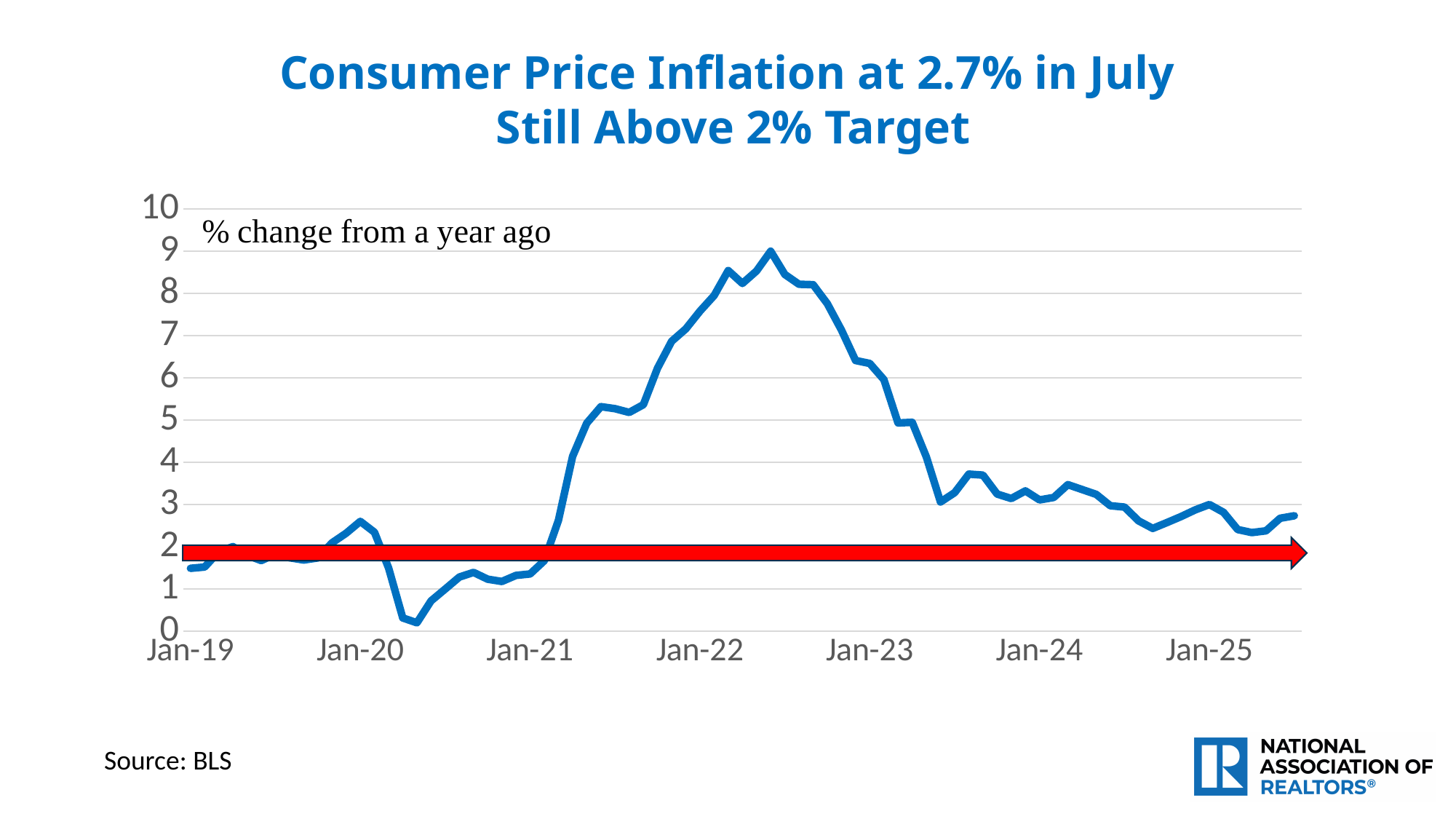
Does the line rise or fall between Jan-23 and Jan-24? fall According to the slide, what was consumer price inflation in July? 2.7% Is the value at Jan-21 greater or less than 2? less Is the value at Jan-23 greater or less than 5? greater What does the text inside the chart say the values represent? % change from a year ago What is the title of the chart? Consumer Price Inflation at 2.7% in July Still Above 2% Target Is the value at Jan-22 greater or less than 6? greater Which is larger, the value at Jan-22 or the value at Jan-24? Jan-22 What kind of chart is shown on the slide? line chart Does the line rise or fall between Jan-21 and Jan-22? rise